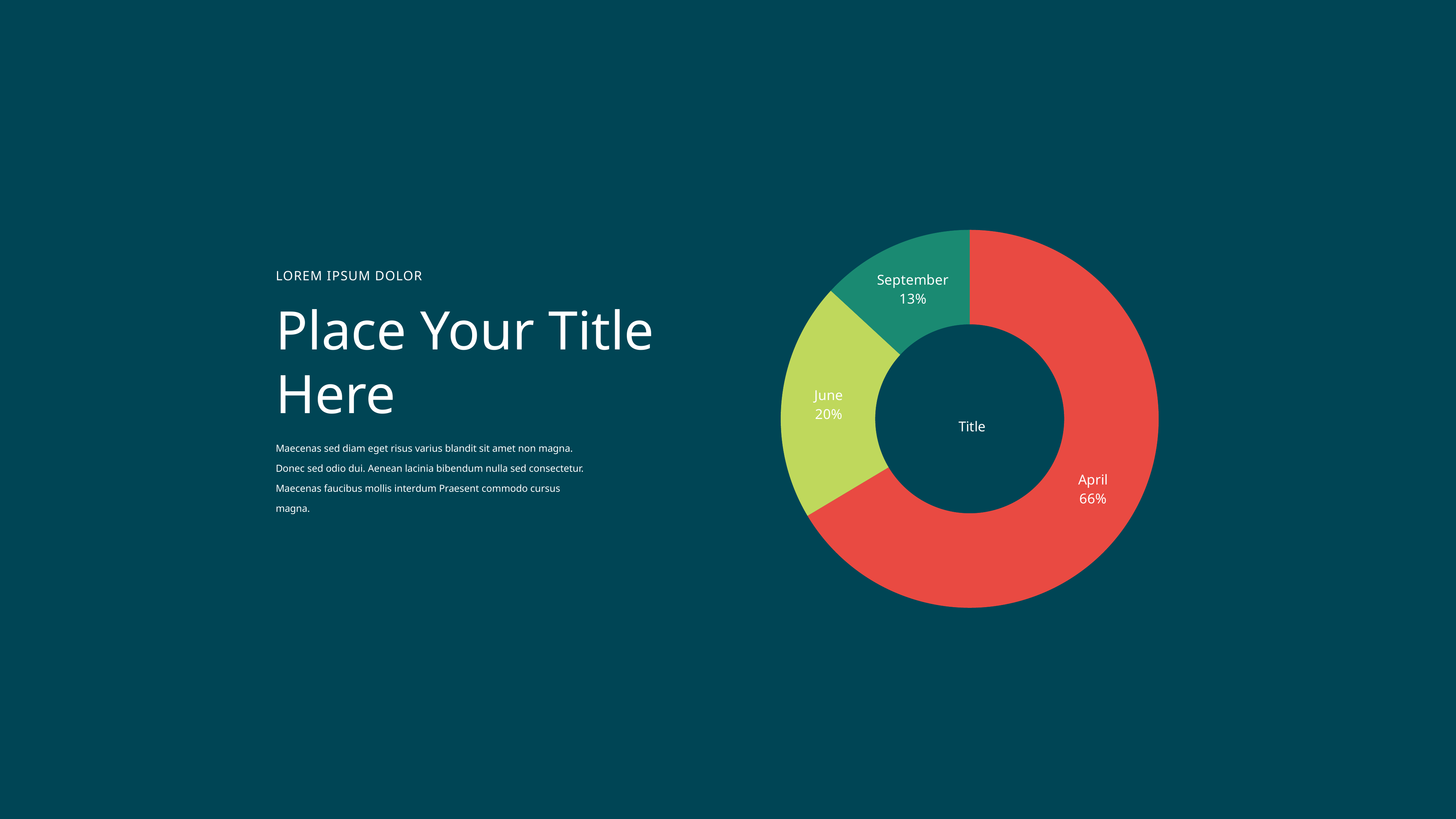
What colour is the April slice of the doughnut chart? Red What is the difference in percentage points between April's and June's shares? 46 What kind of chart is shown on the slide? Doughnut chart Which category has the largest slice in the doughnut chart? April How many slices does the doughnut chart have? 3 What text appears in the centre of the doughnut chart? Title Which is larger, the share for June or the share for September? June What share of the doughnut chart does September represent? 13% What share of the doughnut chart does June represent? 20% What is the difference in percentage points between June's and September's shares? 7 What share of the doughnut chart does April represent? 66% Which category has the smallest slice in the doughnut chart? September